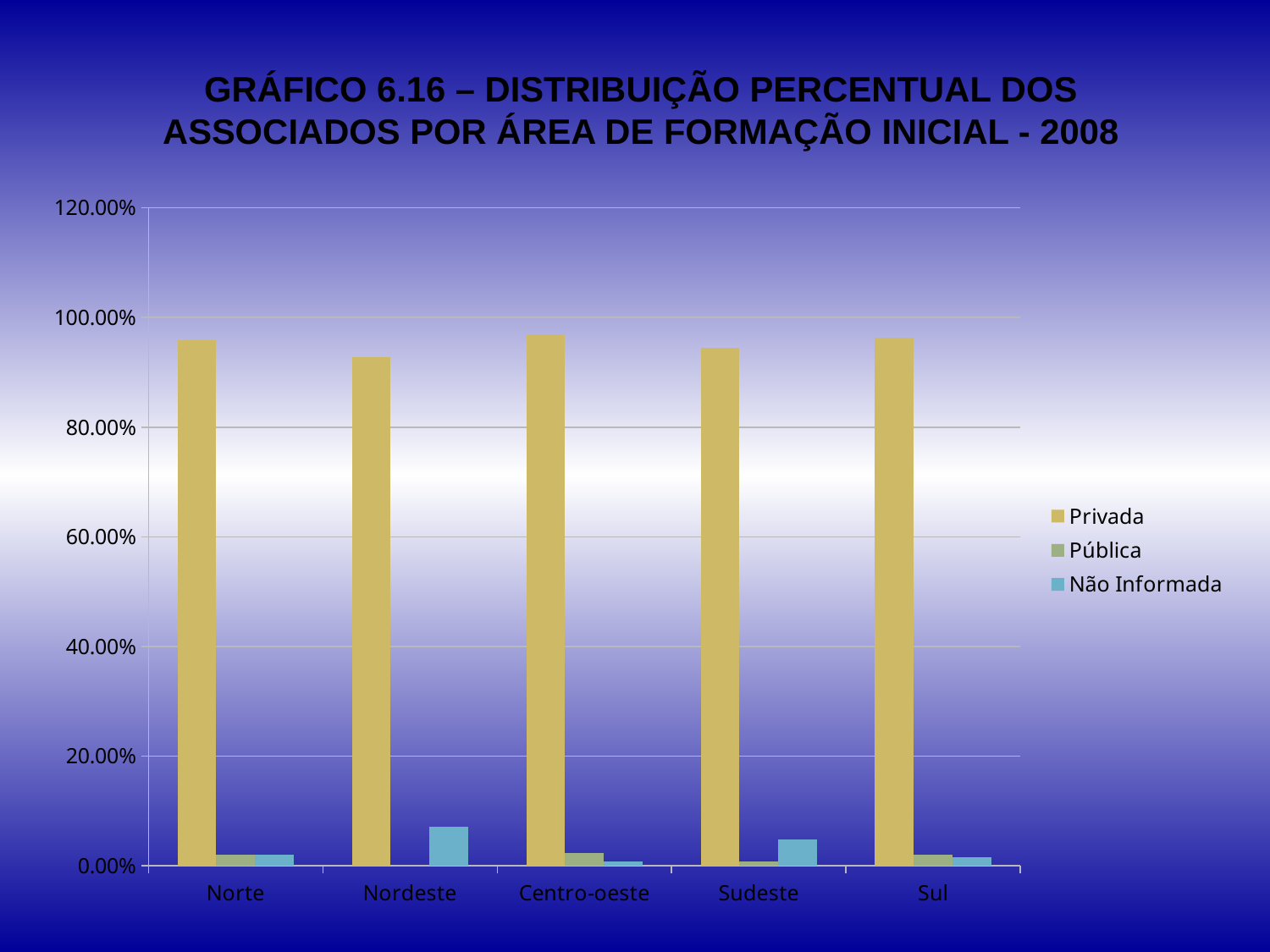
For Não Informada, which region has the larger value: Nordeste or Sudeste? Nordeste Which region has the lowest value for Privada? Nordeste Which series does the legend list first? Privada How many regions are shown on the x axis of the chart? 5 How many series does the legend list? 3 Which region has the highest value for Não Informada? Nordeste What kind of chart is shown on the slide? bar chart Which year is mentioned in the chart title? 2008 Is the value for Não Informada in Nordeste greater or less than 20.00%? less Is the value for Privada in Norte greater or less than 80.00%? greater Is the value for Privada in Nordeste greater or less than 100.00%? less In Nordeste, which is larger: Privada or Não Informada? Privada